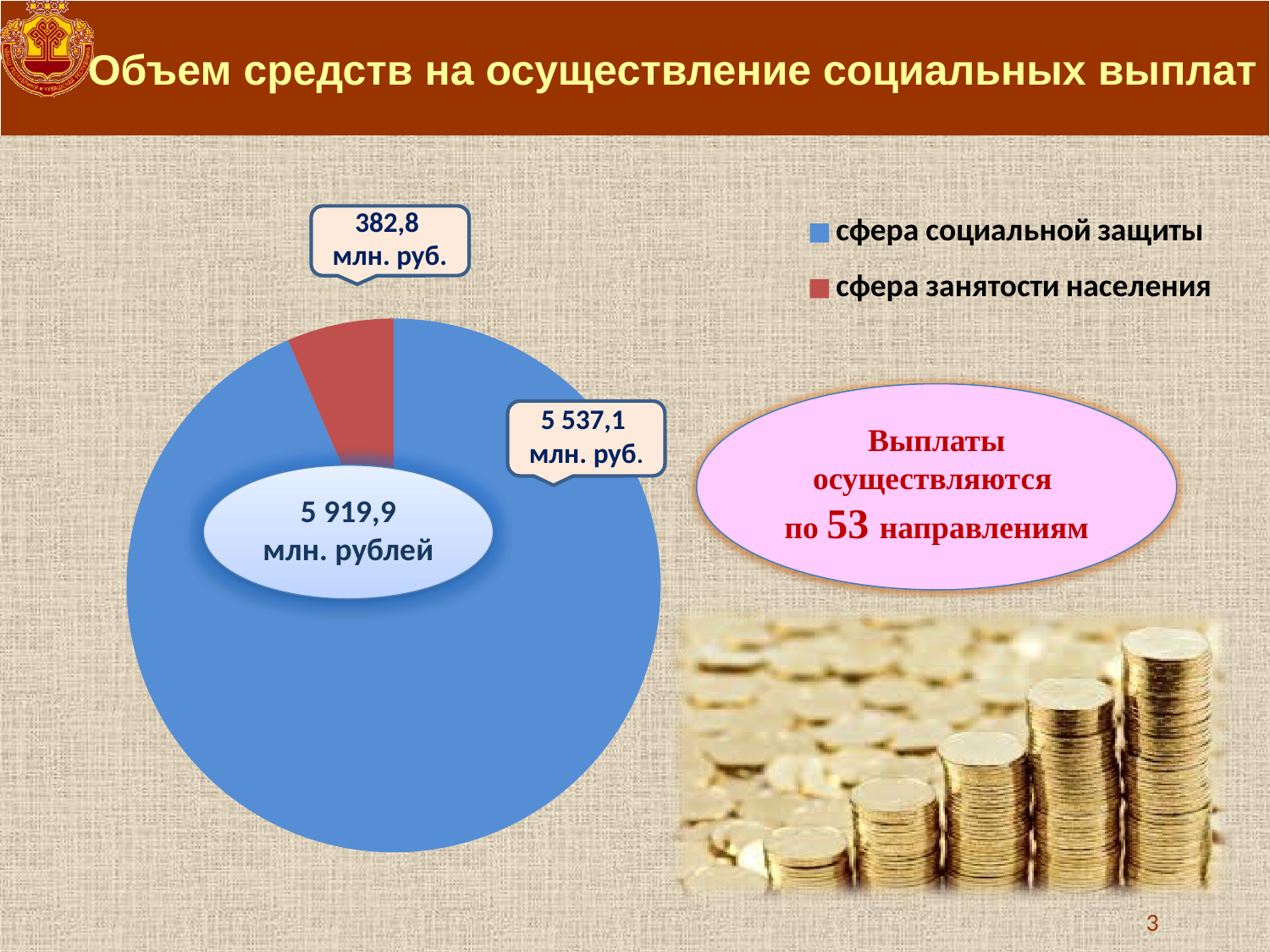
What is the total of the two slices shown in the centre of the pie? 5 919,9 млн. рублей What is the title of the slide containing the chart? Объем средств на осуществление социальных выплат What is the difference between the values for сфера социальной защиты and сфера занятости населения? 5 154,3 млн. руб. What is the value for сфера социальной защиты? 5 537,1 млн. руб. How many entries does the legend list? 2 What is the value for сфера занятости населения? 382,8 млн. руб. How many categories does the pie chart have? 2 Which is larger: сфера социальной защиты or сфера занятости населения? сфера социальной защиты Which category has the largest slice of the pie? сфера социальной защиты Which category has the smallest slice of the pie? сфера занятости населения What colour is the slice for сфера занятости населения? red What type of chart is shown on the slide? pie chart